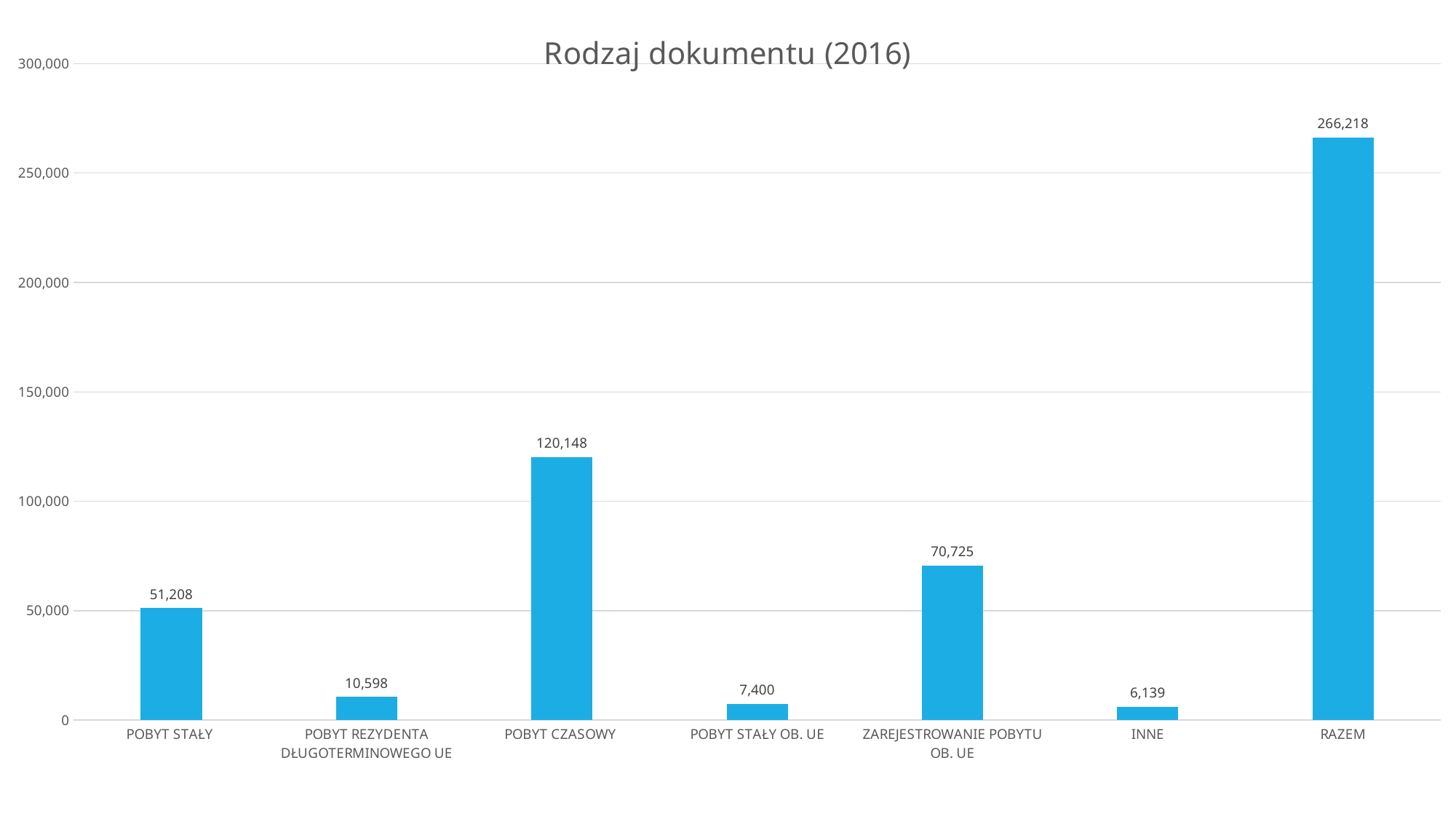
How many categories are shown on the x axis? 7 What is the difference between POBYT CZASOWY and POBYT STAŁY? 68,940 What kind of chart is this? bar chart What is the difference between RAZEM and POBYT CZASOWY? 146,070 What is the value for POBYT CZASOWY? 120,148 What is the value for INNE? 6,139 Which category has the lowest value? INNE What is the value for ZAREJESTROWANIE POBYTU OB. UE? 70,725 What is the title of the chart? Rodzaj dokumentu (2016) Is the value for RAZEM greater or less than 250,000? greater Which category has the highest value? RAZEM Which is larger, POBYT REZYDENTA DŁUGOTERMINOWEGO UE or POBYT STAŁY OB. UE? POBYT REZYDENTA DŁUGOTERMINOWEGO UE